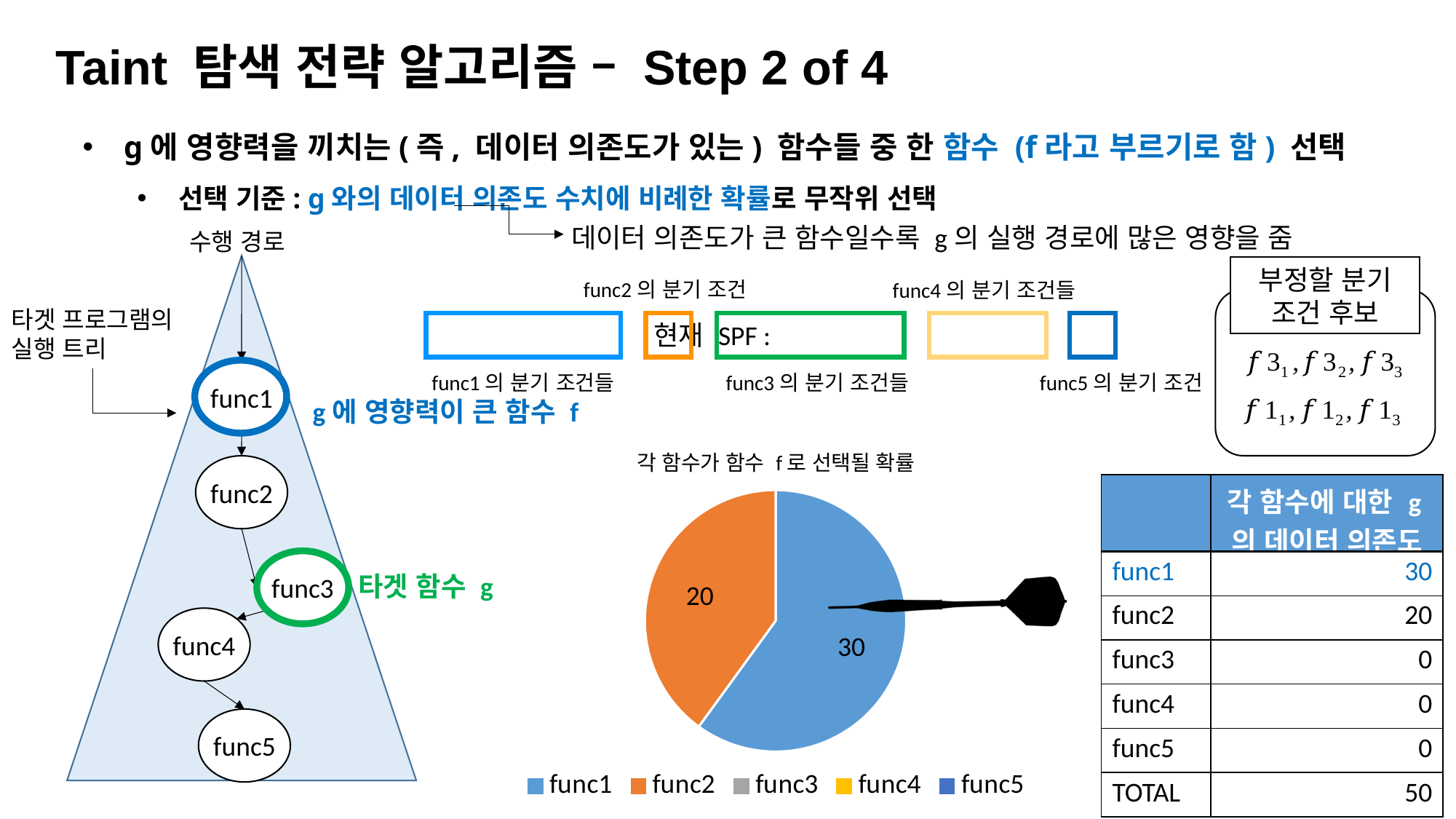
What is the value shown for func2 in the pie chart? 20 What share of the pie does func1 represent? 60% What kind of chart is shown on the slide? pie chart What is the title of the pie chart? 각 함수가 함수 f로 선택될 확률 What is the difference between the func1 and func2 values in the pie chart? 10 How many series does the legend of the pie chart list? 5 What is the total of the values shown in the pie chart? 50 What share of the pie does func2 represent? 40% What colour is the func2 slice in the pie chart? orange Which function has the largest slice in the pie chart? func1 What is the value shown for func1 in the pie chart? 30 Which is larger in the pie chart, func1 or func2? func1